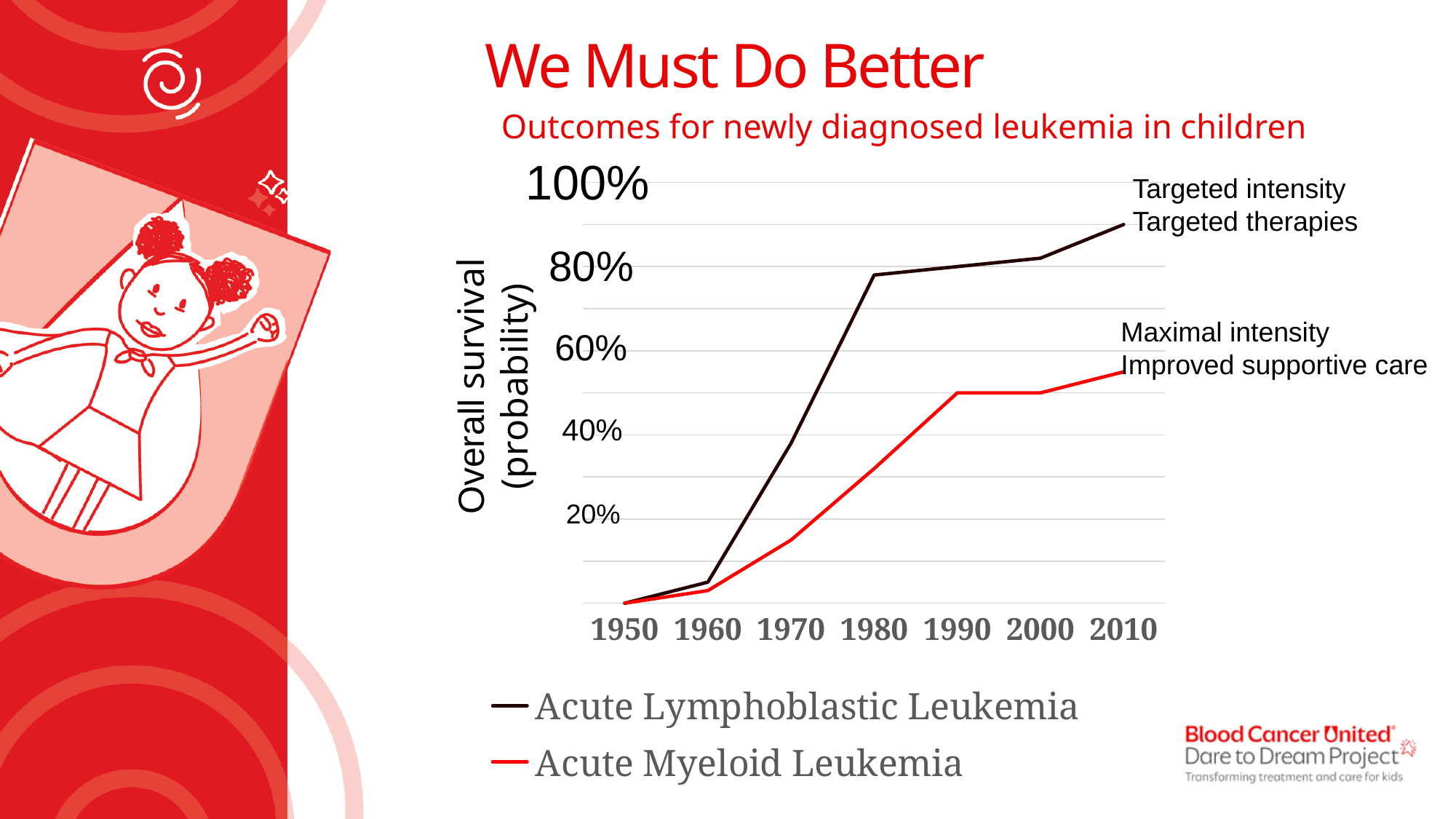
How many years are marked along the x axis? 7 Is the value for Acute Myeloid Leukemia in 1980 greater or less than 40%? less Is the value for Acute Myeloid Leukemia in 2010 greater or less than 60%? less Do the overall survival values for Acute Lymphoblastic Leukemia rise or fall from 1950 to 2010? rise What kind of chart is shown on the slide? line chart In 2010, which series has the higher overall survival, Acute Lymphoblastic Leukemia or Acute Myeloid Leukemia? Acute Lymphoblastic Leukemia Is the value for Acute Lymphoblastic Leukemia in 1980 greater or less than 60%? greater How many series does the legend list? 2 Which series is drawn in red? Acute Myeloid Leukemia What is the y-axis label of the chart? Overall survival (probability) In which year is the Acute Myeloid Leukemia line at its highest? 2010